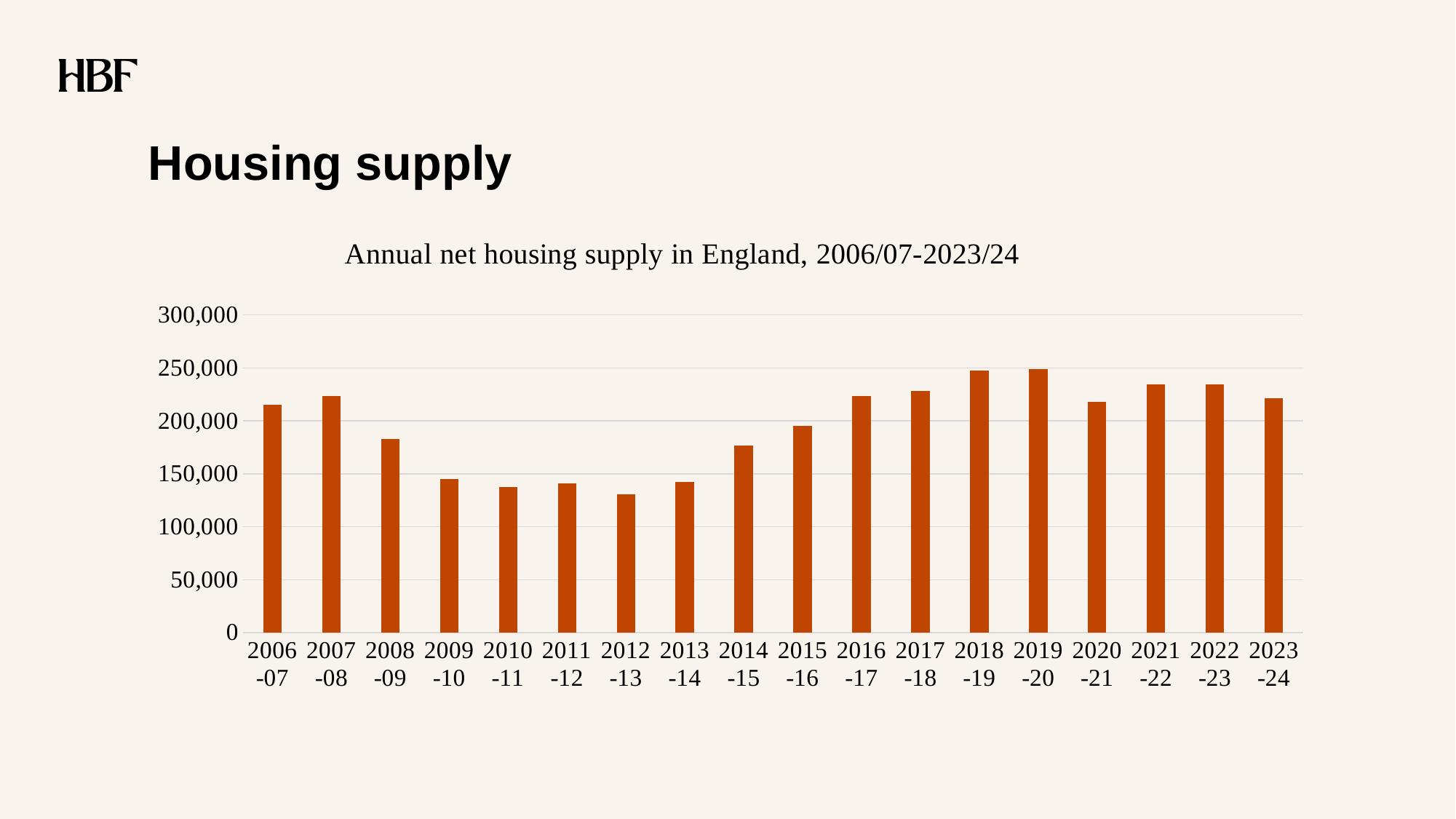
Which year has the lowest annual net housing supply? 2012-13 Which is larger, the value for 2020-21 or the value for 2021-22? 2021-22 Which is larger, the value for 2008-09 or the value for 2009-10? 2008-09 Is the value for 2012-13 greater or less than 150,000? less How many years (bars) are shown on the chart? 18 What kind of chart is shown on the slide? Bar chart What is the title of the chart? Annual net housing supply in England, 2006/07-2023/24 Is the value for 2008-09 greater or less than 150,000? greater Is the value for 2018-19 greater or less than 200,000? greater Do the values rise or fall from 2012-13 to 2019-20? Rise